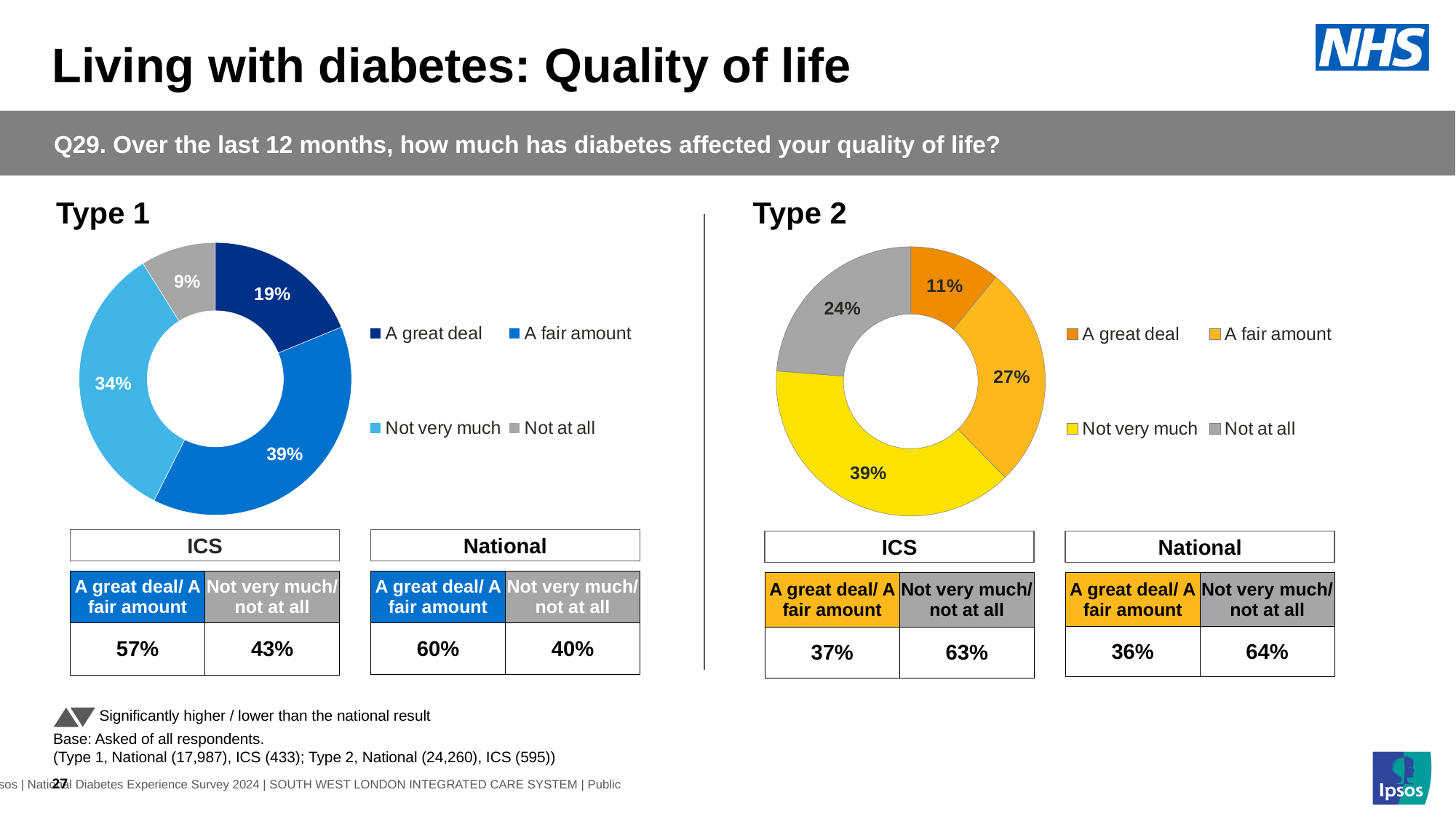
In the Type 2 chart, which is larger: 'A fair amount' or 'A great deal'? A fair amount In the Type 1 chart, what is the combined share of 'A great deal' and 'A fair amount'? 58% In the Type 2 chart, what percentage of respondents said 'Not at all'? 24% What kind of chart is used for Type 2? Doughnut (pie) chart In the Type 2 chart, what is the combined share of 'Not very much' and 'Not at all'? 63% In the Type 2 chart, which category has the largest share? Not very much In the Type 1 chart, what colour is the 'Not very much' segment? Light blue In the Type 1 chart, which category has the smallest share? Not at all In the Type 1 chart, what percentage of respondents said diabetes affected their quality of life 'A fair amount'? 39% In the Type 2 chart, what colour is the 'A great deal' segment? Orange In the Type 1 chart, what is the difference between the 'A fair amount' and 'A great deal' shares? 20 percentage points How many categories does the Type 1 chart show? 4